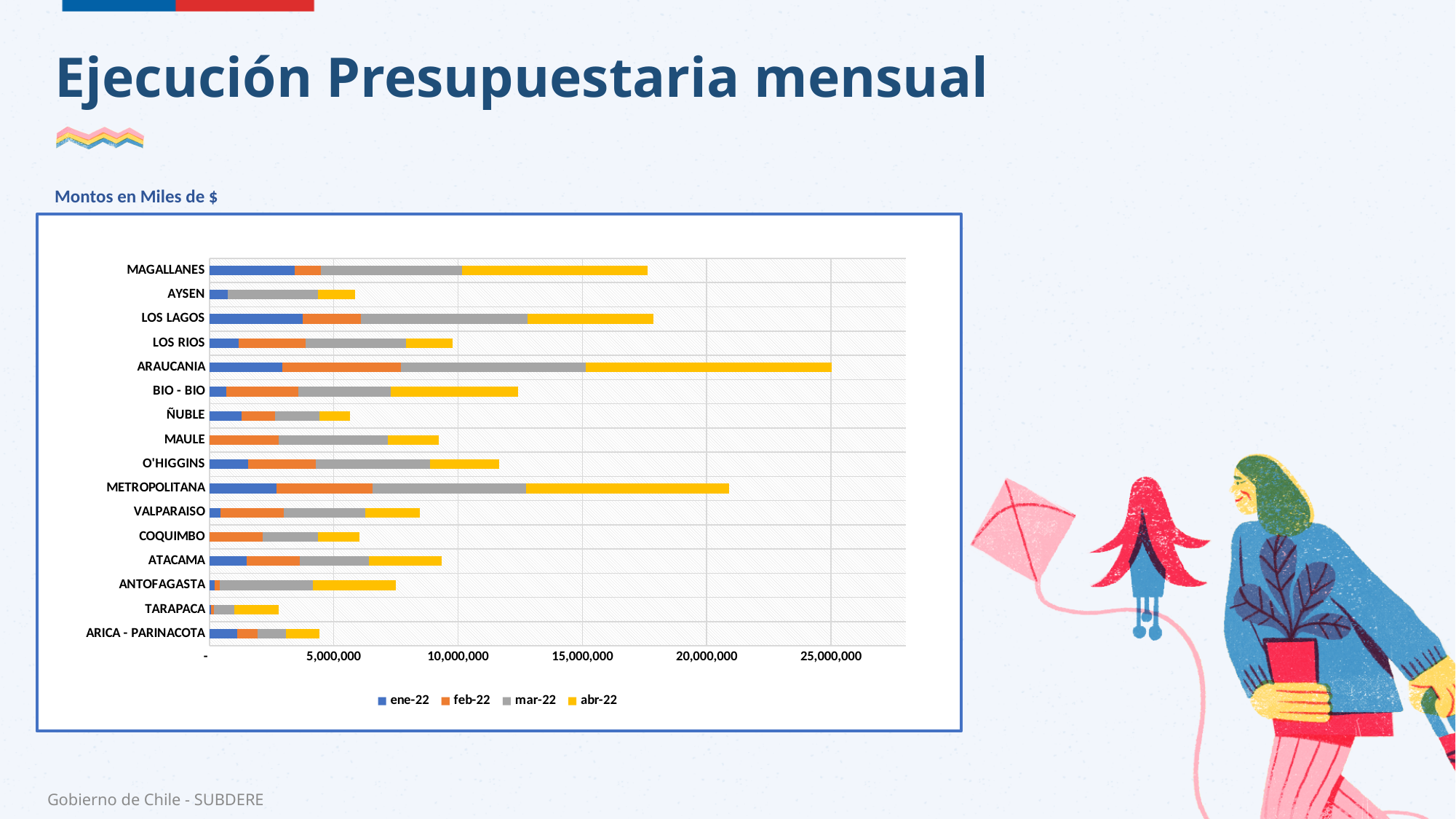
Is the total bar for ARAUCANIA greater or less than 20,000,000? greater What kind of chart is shown on the slide? Stacked bar chart How many series does the chart legend list? 4 Which region has a longer total bar, METROPOLITANA or MAGALLANES? METROPOLITANA In what units are the amounts on the chart expressed, according to the label above the chart? Miles de $ Which region has the shortest total bar on the chart? TARAPACA Is the total bar for TARAPACA greater or less than 5,000,000? less Is the total bar for MAGALLANES greater or less than 15,000,000? greater Which region has the longest total bar on the chart? ARAUCANIA How many regions (categories) are plotted on the chart? 16 What are the series names listed in the chart legend? ene-22, feb-22, mar-22, abr-22